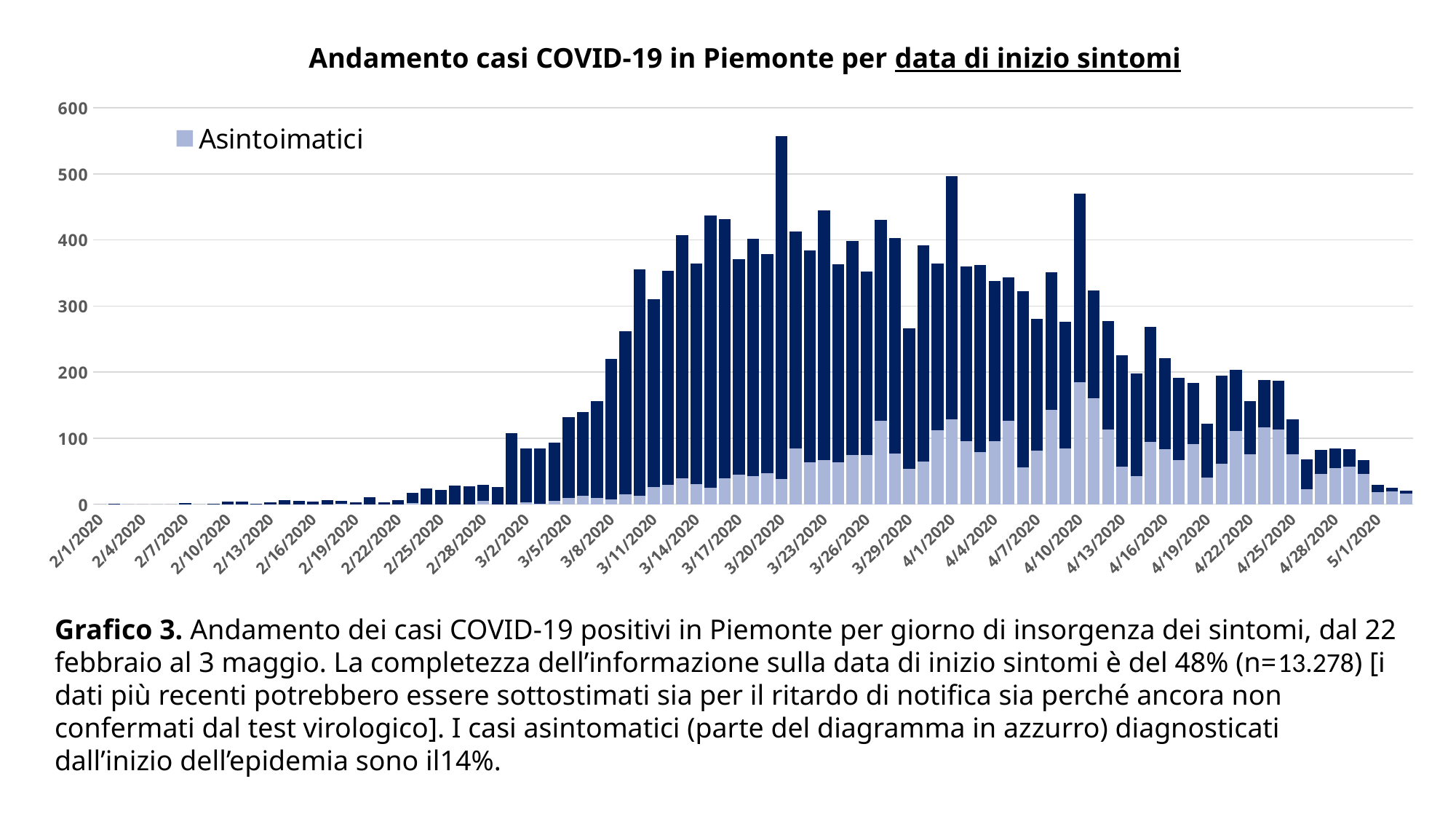
Is the value for 4/10/2020 greater or less than 400? greater Is the value for 4/1/2020 greater or less than 400? greater What is the title of the chart? Andamento casi COVID-19 in Piemonte per data di inizio sintomi Do the bar values generally rise or fall from 2/22/2020 to 3/20/2020? rise What is the name of the series shown in the legend? Asintoimatici Is the value for 5/1/2020 greater or less than 100? less How many series does the chart's legend list? 1 What kind of chart is shown on the slide? bar chart Do the bar values generally rise or fall from 4/10/2020 to 5/1/2020? fall Which date has the highest bar in the chart? 3/20/2020